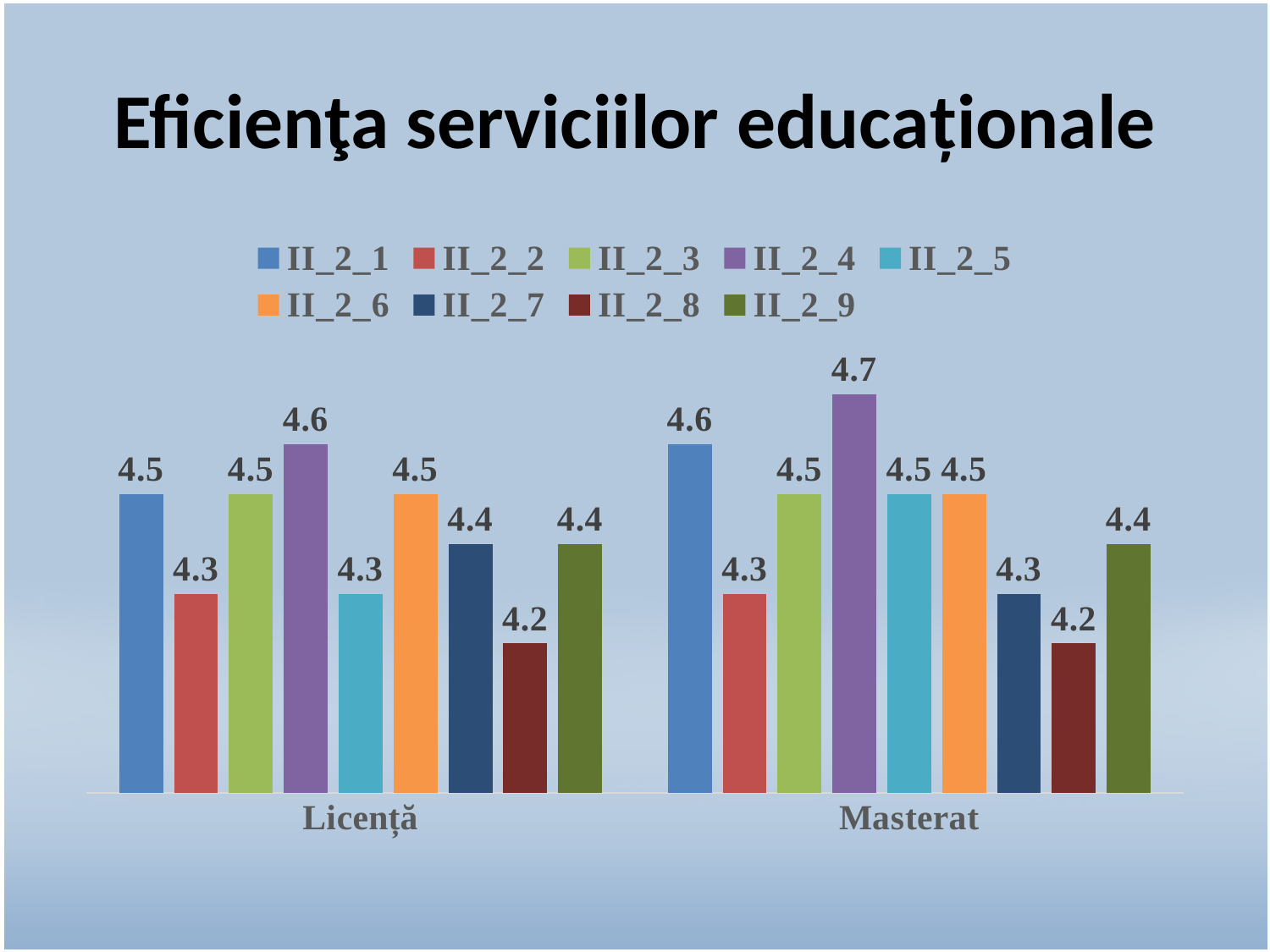
What is the difference between II_2_4 and II_2_8 for Masterat? 0.5 How many categories are shown on the x axis? 2 How many series does the legend list? 9 What is the value of II_2_8 for Masterat? 4.2 Which series has the lowest value for Licență? II_2_8 What kind of chart is shown on the slide? bar chart What is the value of II_2_1 for Licență? 4.5 What is the value of II_2_7 for Licență? 4.4 What is the title of the slide? Eficienţa serviciilor educaţionale Which series has the highest value for Masterat? II_2_4 What is the value of II_2_4 for Masterat? 4.7 Which is larger, II_2_1 for Licență or II_2_1 for Masterat? Masterat